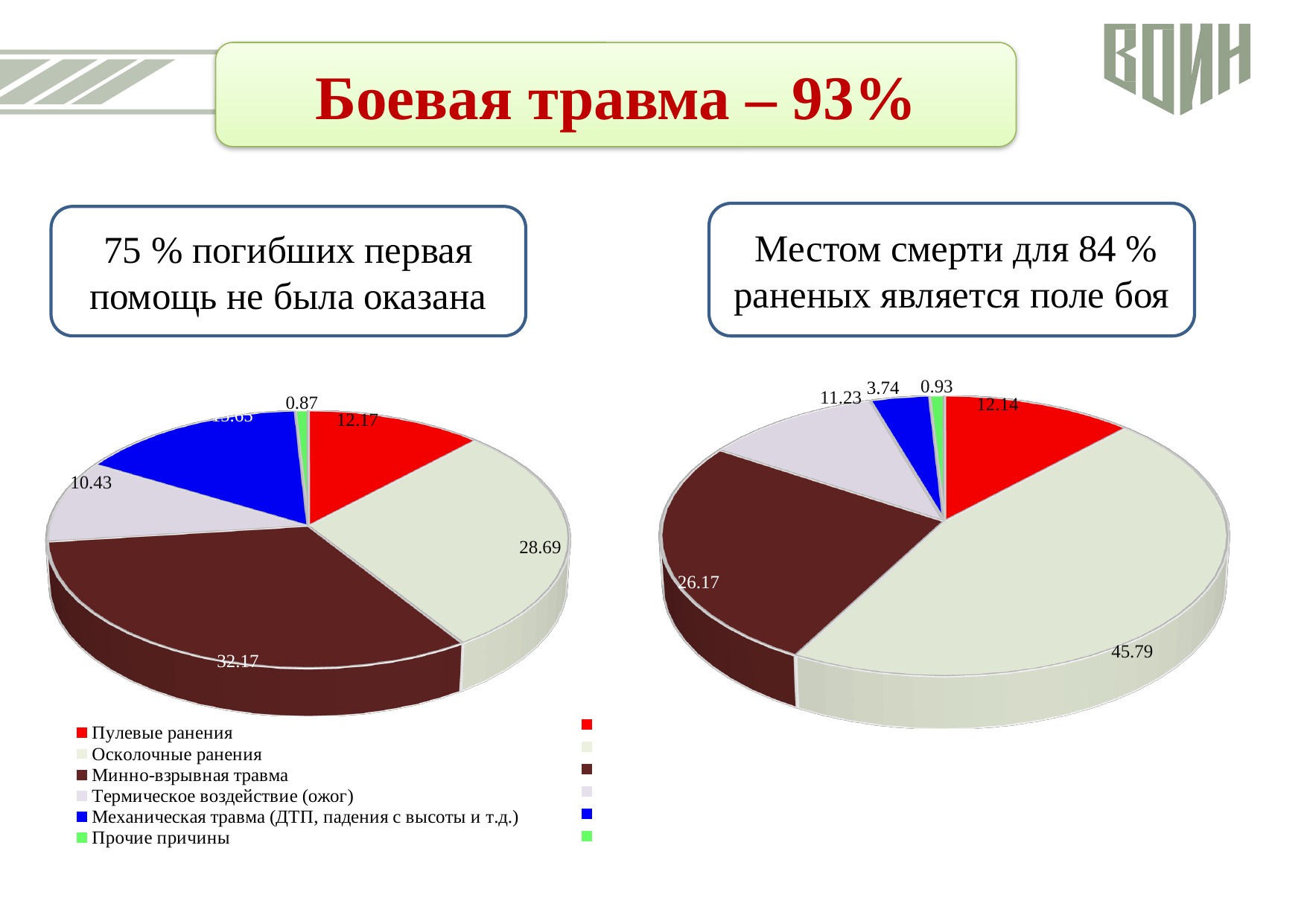
How many categories does the legend list? 6 What colour represents Минно-взрывная травма in the pie charts? dark brown In the left pie chart, what is the value for Осколочные ранения? 28.69 In the left pie chart, which category has the smallest slice? Прочие причины In the left pie chart, what is the value for Минно-взрывная травма? 32.17 In the left pie chart, which is larger: Пулевые ранения or Термическое воздействие (ожог)? Пулевые ранения In the left pie chart, what is the value for Прочие причины? 0.87 What kind of chart is the left chart on the slide? pie chart